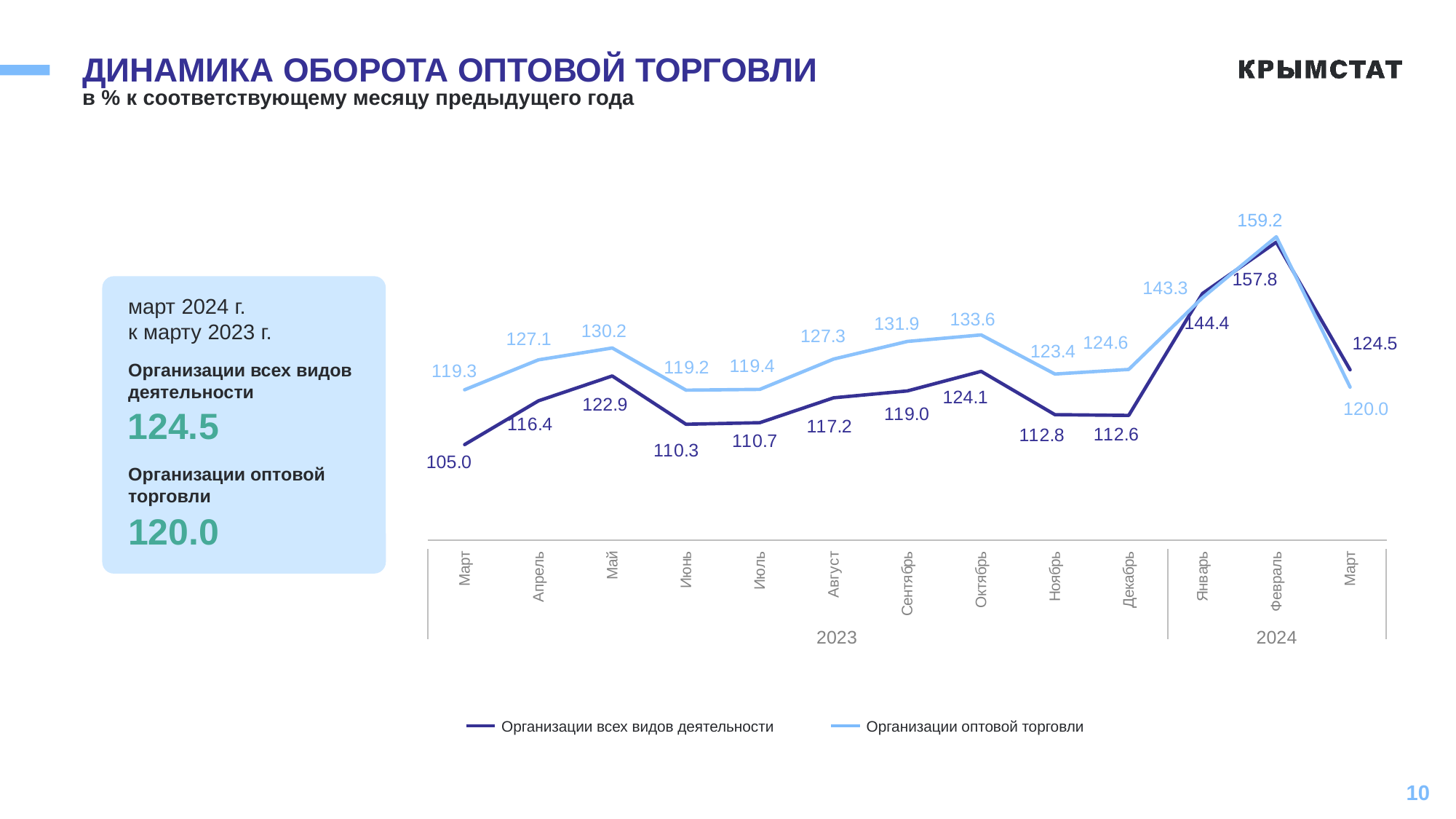
What type of chart is shown on the slide? line chart What is the value for Организации всех видов деятельности in Март 2023? 105.0 Which series has the larger value in Январь 2024? Организации всех видов деятельности In which month is the value for Организации всех видов деятельности the lowest? Март 2023 How many months (data points) are plotted along the x axis? 13 In which month does Организации оптовой торговли reach its highest value? Февраль 2024 What is the value for Организации всех видов деятельности in Февраль 2024? 157.8 What is the value for Организации оптовой торговли in Октябрь 2023? 133.6 What colour is the line for Организации оптовой торговли? light blue What is the difference between Организации оптовой торговли and Организации всех видов деятельности in Март 2024? 4.5 Do the values for Организации всех видов деятельности rise or fall from Февраль 2024 to Март 2024? fall How many series does the legend list? 2